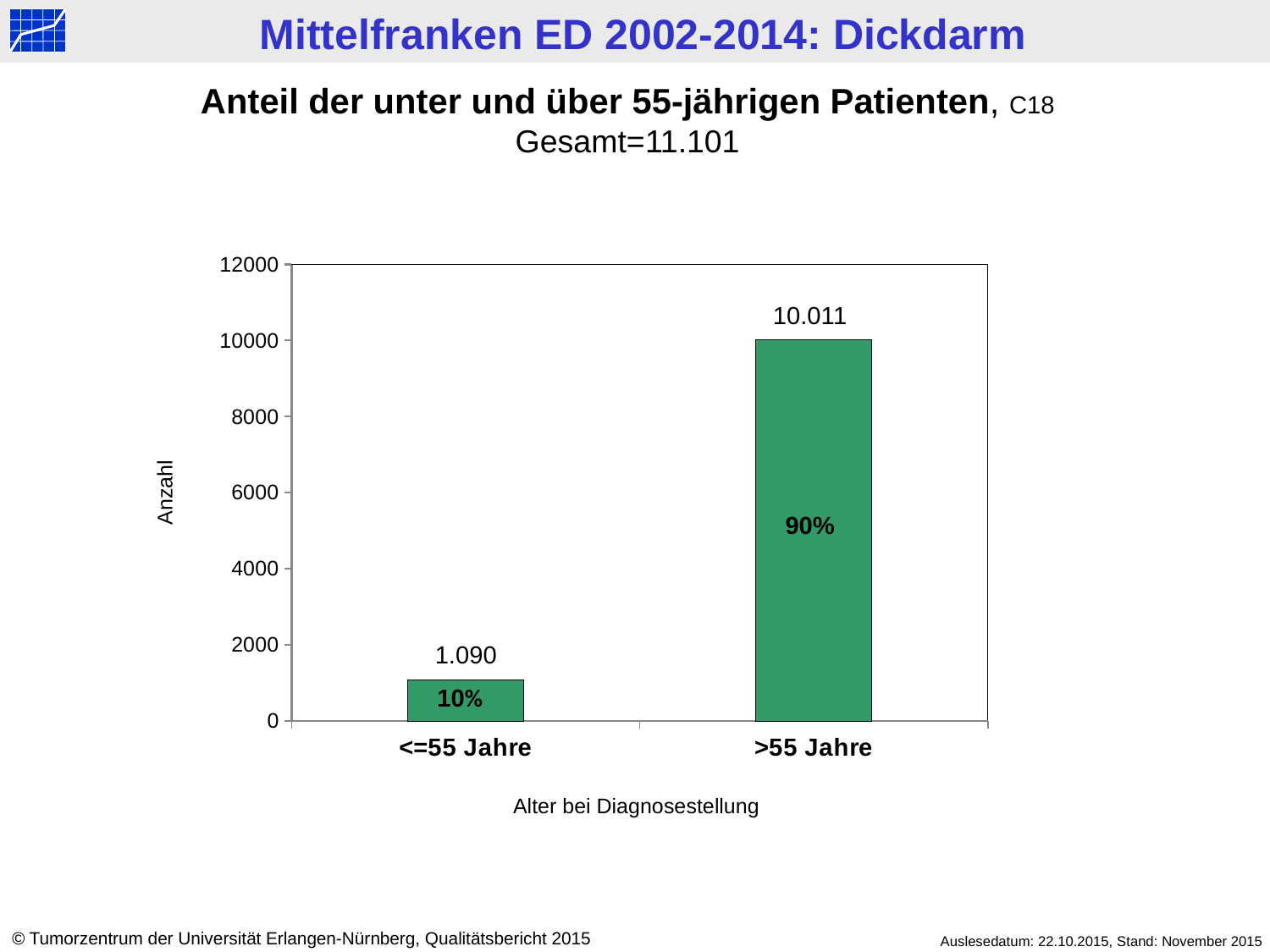
Which is larger, the value for <=55 Jahre or for >55 Jahre? >55 Jahre How many categories are shown on the x axis? 2 What percentage is shown on the <=55 Jahre bar? 10% What is the difference between the values for >55 Jahre and <=55 Jahre? 8.921 What is the label of the x axis? Alter bei Diagnosestellung What is the value for the <=55 Jahre category? 1.090 What is the value for the >55 Jahre category? 10.011 Is the value for >55 Jahre greater or less than 8000? greater What percentage is shown on the >55 Jahre bar? 90% What kind of chart is shown on the slide? bar chart Which category has the highest value? >55 Jahre Which category has the lowest value? <=55 Jahre